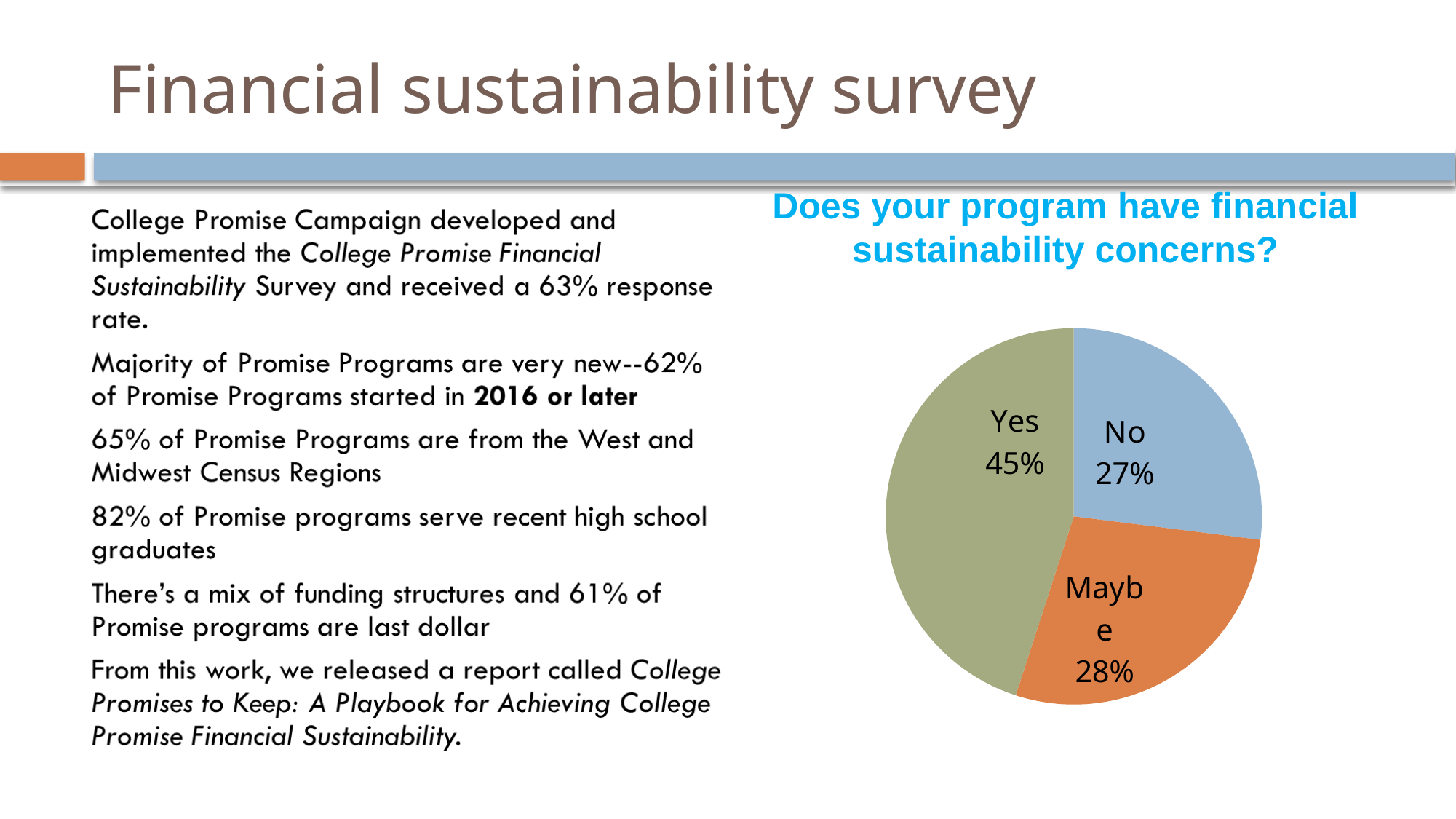
Which is larger, the share for "Yes" or the share for "Maybe"? Yes What percentage of programs answered "Maybe"? 28% Which response has the largest share of the pie? Yes What colour is the "Maybe" slice of the pie chart? Orange What kind of chart is shown on the slide? Pie chart What is the difference in percentage points between the "Maybe" and "No" responses? 1 Which response has the smallest share of the pie? No What percentage of programs answered "Yes" to having financial sustainability concerns? 45% What percentage of programs answered "No"? 27% How many slices does the pie chart have? 3 What is the title of the pie chart? Does your program have financial sustainability concerns? What is the difference in percentage points between the "Yes" and "No" responses? 18